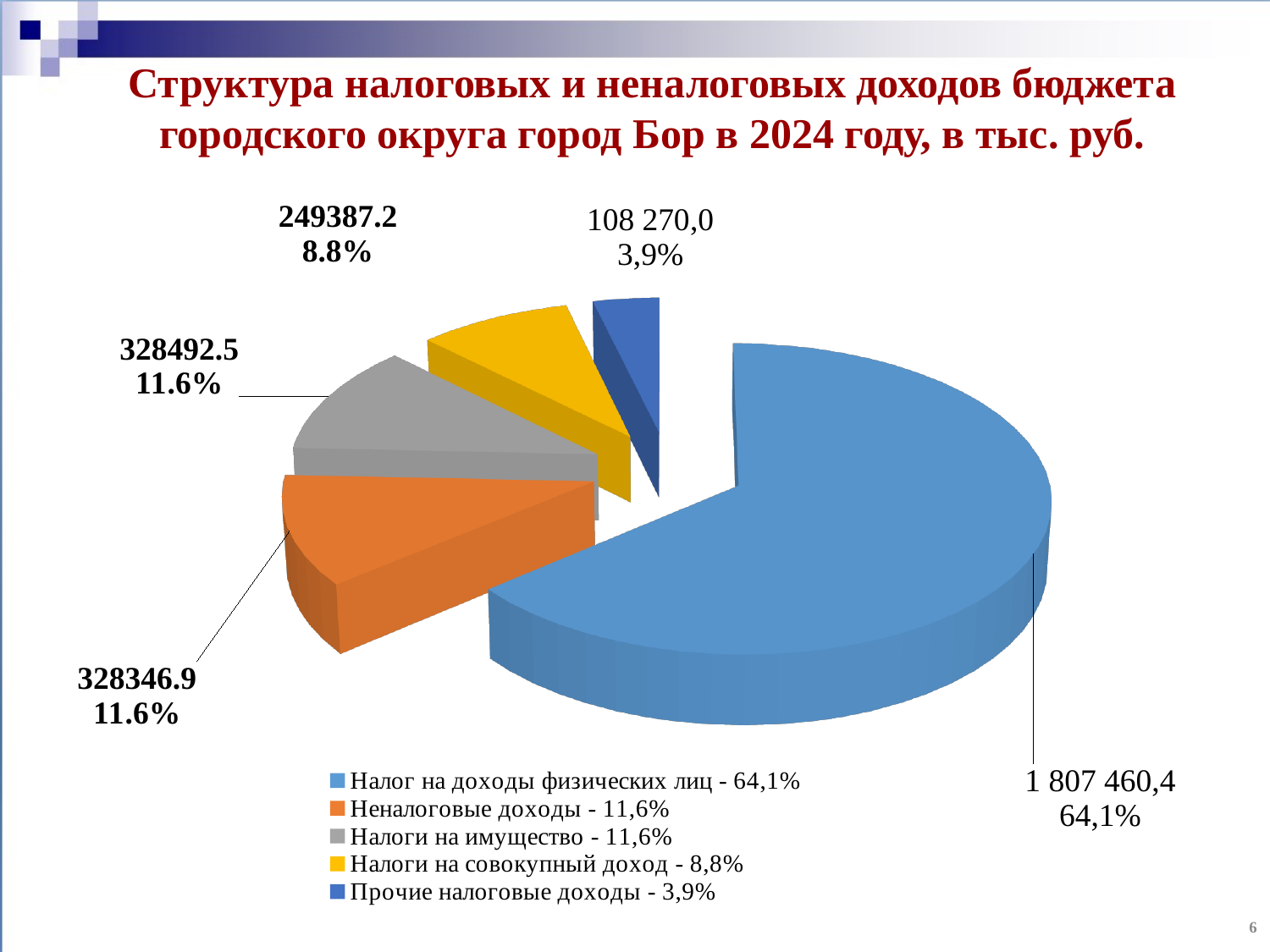
What is the value shown for Налог на доходы физических лиц? 1 807 460,4 What kind of chart is shown on the slide? pie chart Which is larger, the value for Налоги на совокупный доход or the value for Прочие налоговые доходы? Налоги на совокупный доход What is the value shown for Налоги на совокупный доход? 249387.2 What colour is the slice for Неналоговые доходы? orange How many entries does the legend of the pie chart list? 5 What share of the pie does Налоги на совокупный доход represent? 8.8% Which category has the largest slice of the pie? Налог на доходы физических лиц What is the value shown for Налоги на имущество? 328492.5 What is the value shown for Прочие налоговые доходы? 108 270,0 How many slices does the pie chart have? 5 Which category has the smallest slice of the pie? Прочие налоговые доходы